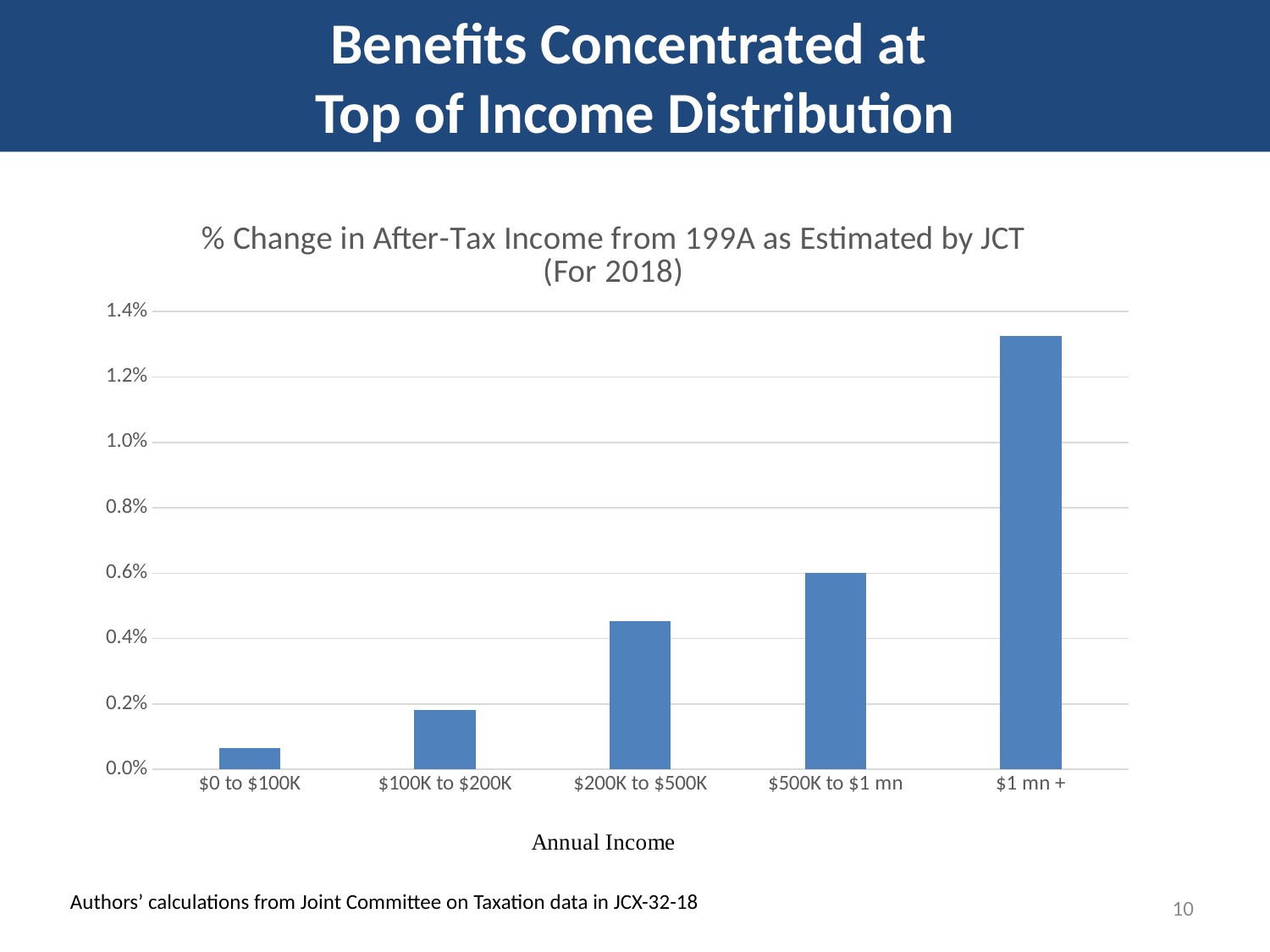
Is the value for $100K to $200K greater or less than 0.2%? less How many income categories are shown on the x axis? 5 Do the values rise or fall as income increases along the x axis? rise Which income category has the highest % change in after-tax income? $1 mn + Which income category has the lowest % change in after-tax income? $0 to $100K Which is larger, the value for $200K to $500K or the value for $100K to $200K? $200K to $500K What is the label of the x axis? Annual Income What kind of chart is shown on the slide? bar chart Is the value for $500K to $1 mn greater or less than 0.4%? greater Is the value for $200K to $500K greater or less than 0.4%? greater What year does the chart title say the estimates are for? 2018